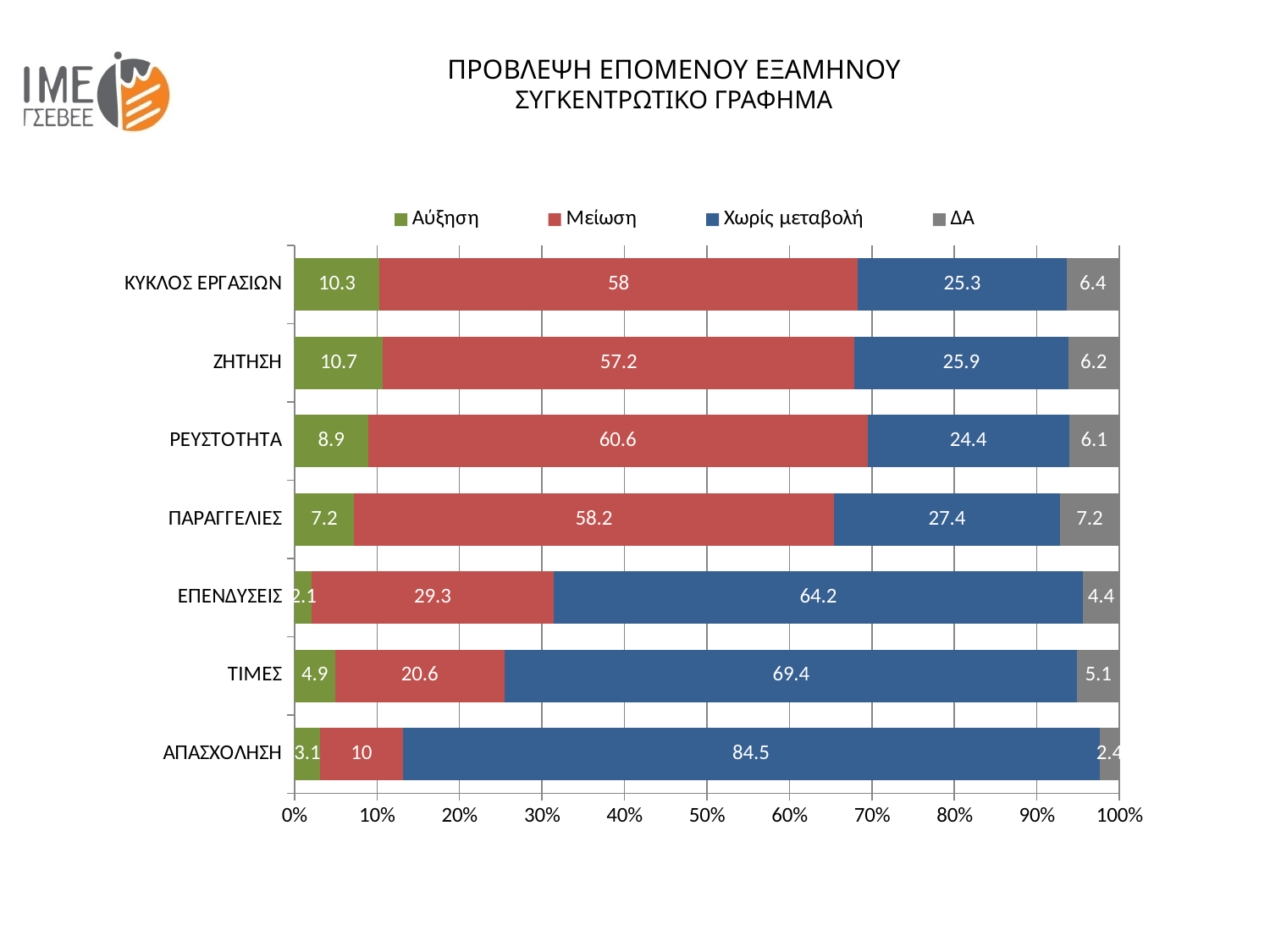
Which category has the highest value for Χωρίς μεταβολή? ΑΠΑΣΧΟΛΗΣΗ What is the value of Μείωση for ΡΕΥΣΤΟΤΗΤΑ? 60.6 What is the value of Χωρίς μεταβολή for ΕΠΕΝΔΥΣΕΙΣ? 64.2 What is the value of ΔΑ for ΠΑΡΑΓΓΕΛΙΕΣ? 7.2 How many series does the legend list? 4 How many categories are shown on the chart? 7 What type of chart is shown on the slide? Stacked bar chart What is the difference between the Χωρίς μεταβολή values for ΑΠΑΣΧΟΛΗΣΗ and ΤΙΜΕΣ? 15.1 What is the total of the stacked bar for ΚΥΚΛΟΣ ΕΡΓΑΣΙΩΝ? 100 Which has a larger Μείωση value, ΕΠΕΝΔΥΣΕΙΣ or ΤΙΜΕΣ? ΕΠΕΝΔΥΣΕΙΣ Which category has the lowest value for Αύξηση? ΕΠΕΝΔΥΣΕΙΣ What is the title of the chart? ΠΡΟΒΛΕΨΗ ΕΠΟΜΕΝΟΥ ΕΞΑΜΗΝΟΥ ΣΥΓΚΕΝΤΡΩΤΙΚΟ ΓΡΑΦΗΜΑ